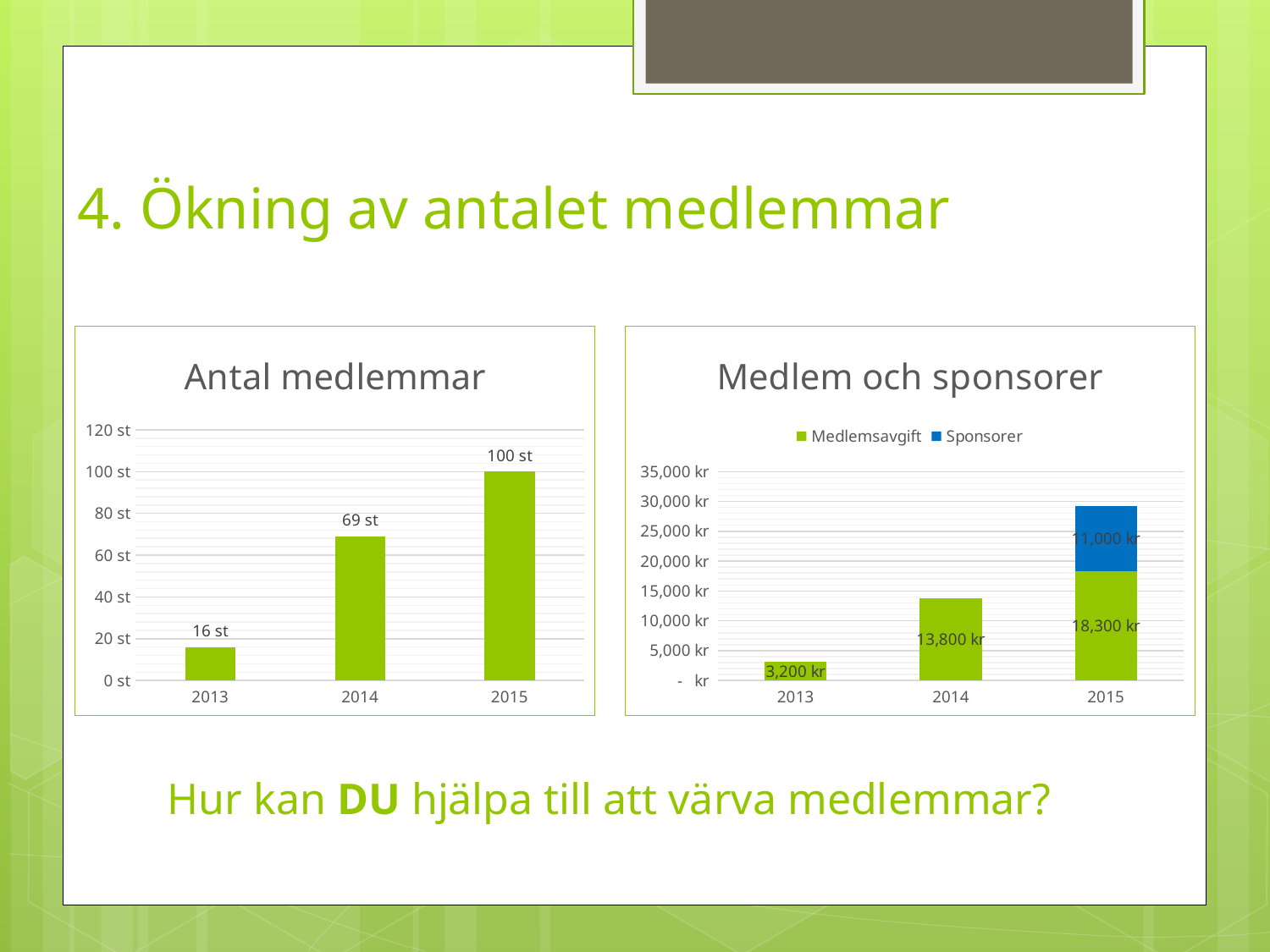
In the 'Antal medlemmar' chart, what is the difference between the values for 2015 and 2013? 84 st What kind of chart is 'Medlem och sponsorer'? bar chart In the 'Medlem och sponsorer' chart, what is the Sponsorer value for 2015? 11,000 kr In the 'Antal medlemmar' chart, what is the value for 2014? 69 st In the 'Medlem och sponsorer' chart, is the Medlemsavgift value for 2013 greater or less than 5,000 kr? less In the 'Antal medlemmar' chart, do the values rise or fall from 2013 to 2015? rise In the 'Medlem och sponsorer' chart, how many series does the legend list? 2 In the 'Antal medlemmar' chart, how many years are shown on the x axis? 3 In the 'Antal medlemmar' chart, which year has the lowest value? 2013 In the 'Medlem och sponsorer' chart, what is the total of the stacked bar for 2015? 29,300 kr In the 'Medlem och sponsorer' chart, what is the Medlemsavgift value for 2014? 13,800 kr In the 'Antal medlemmar' chart, which year has the highest value? 2015